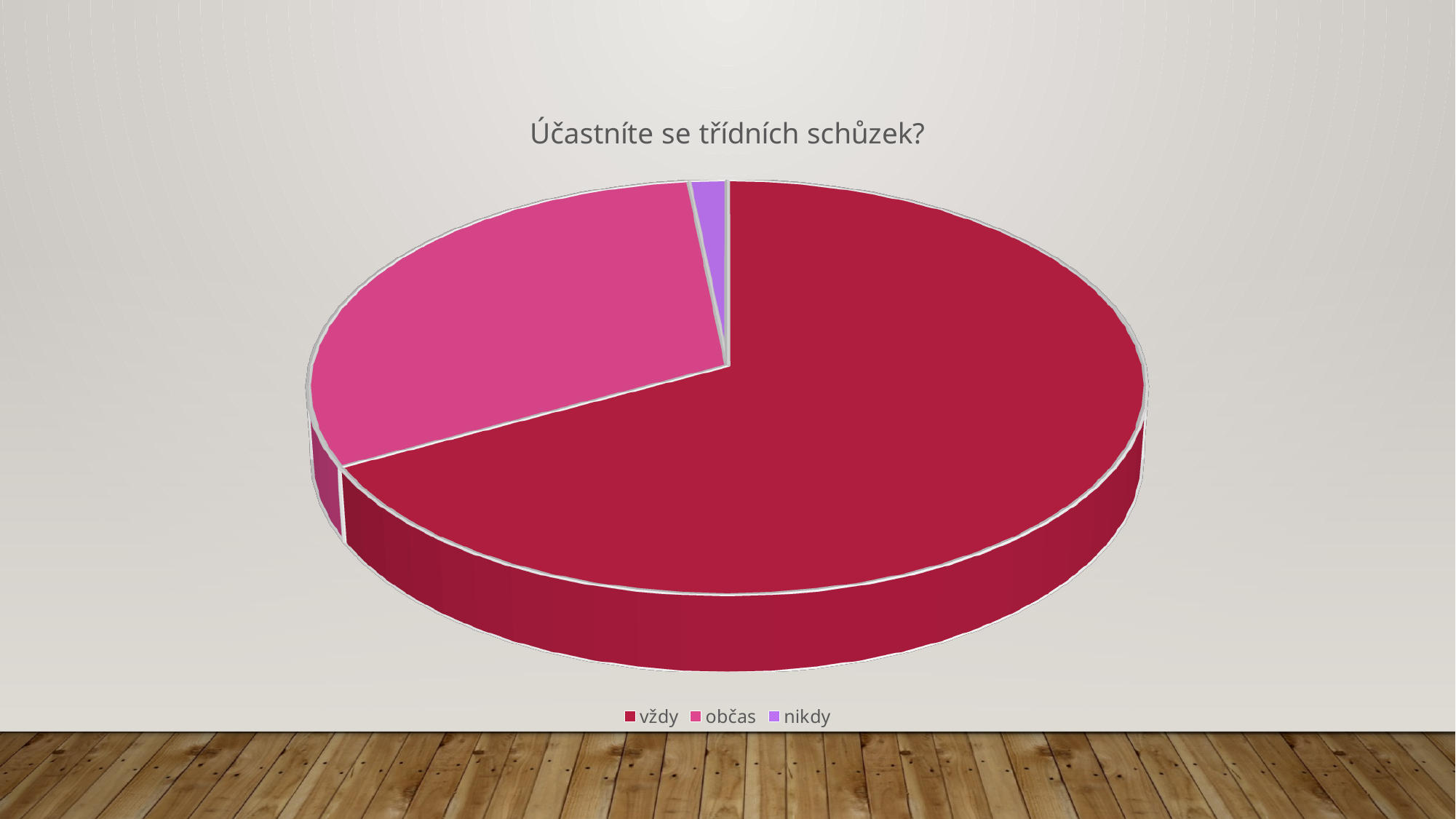
Which category has the smallest slice of the pie? nikdy Which category is shown in the purple colour? nikdy What kind of chart is shown on the slide? pie chart Which category has the largest slice of the pie? vždy Does the vždy slice take up more or less than half of the pie? more What is the title of the chart? Účastníte se třídních schůzek? Which slice is larger, vždy or občas? vždy How many entries does the legend list? 3 How many slices does the pie chart have? 3 Which slice is larger, občas or nikdy? občas